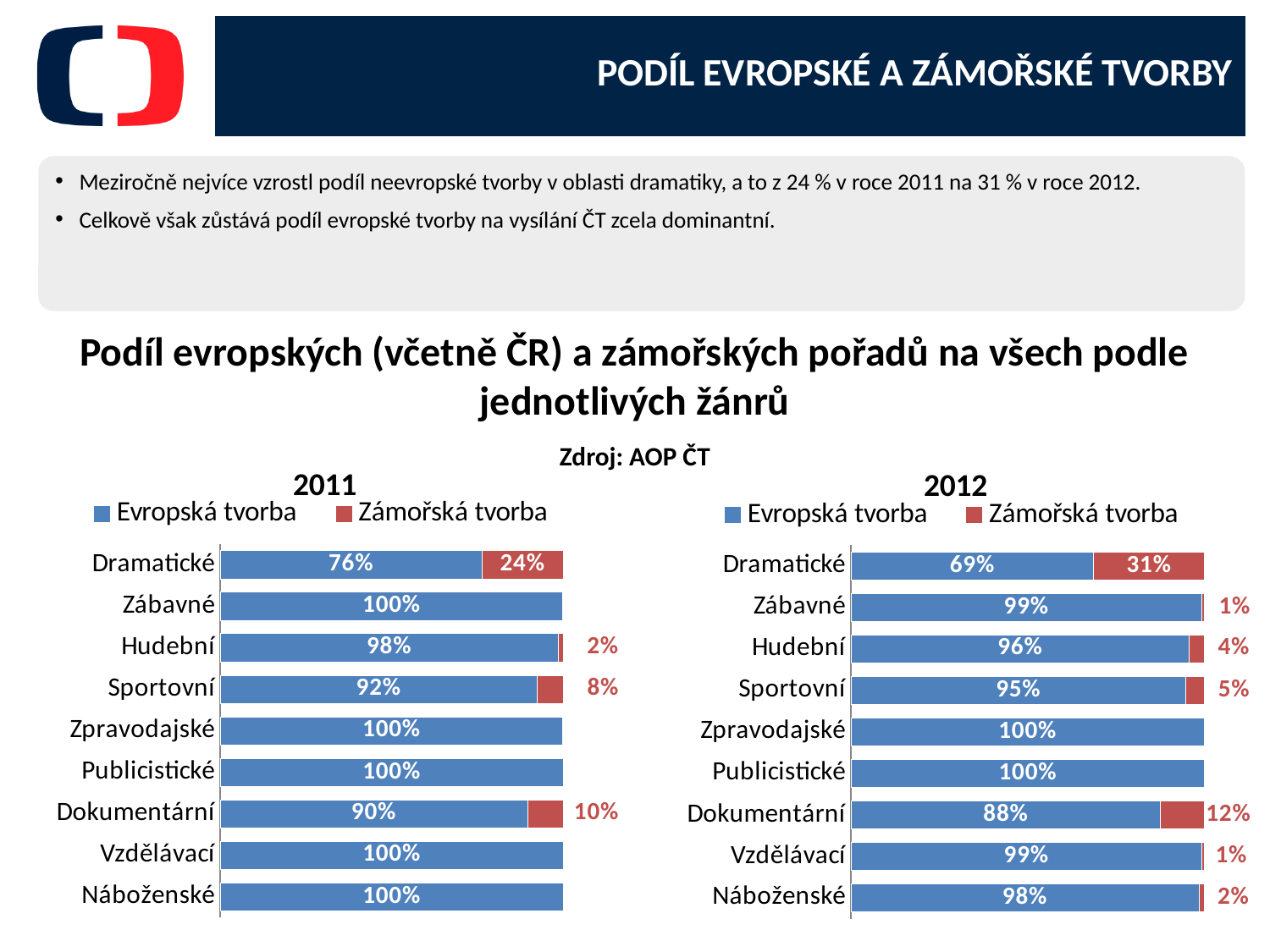
What type of chart is the 2011 chart? Stacked bar chart What is the difference between the Evropská tvorba value for Dramatické in the 2011 chart and in the 2012 chart? 7% In the 2012 chart, which is larger: the Zámořská tvorba value for Hudební or for Sportovní? Sportovní In the 2012 chart, what is the value of Evropská tvorba for Sportovní? 95% In the 2012 chart, which category has the highest share of Zámořská tvorba? Dramatické In the 2012 chart, what colour represents Zámořská tvorba? Red In the 2011 chart, which category has the lowest share of Evropská tvorba? Dramatické How many series does the legend of the 2012 chart list? 2 In the 2012 chart, what is the value of Zámořská tvorba for Dramatické? 31% How many categories are shown in the 2011 chart? 9 In the 2011 chart, what is the value of Evropská tvorba for Dramatické? 76% In the 2011 chart, what is the value of Zámořská tvorba for Dokumentární? 10%